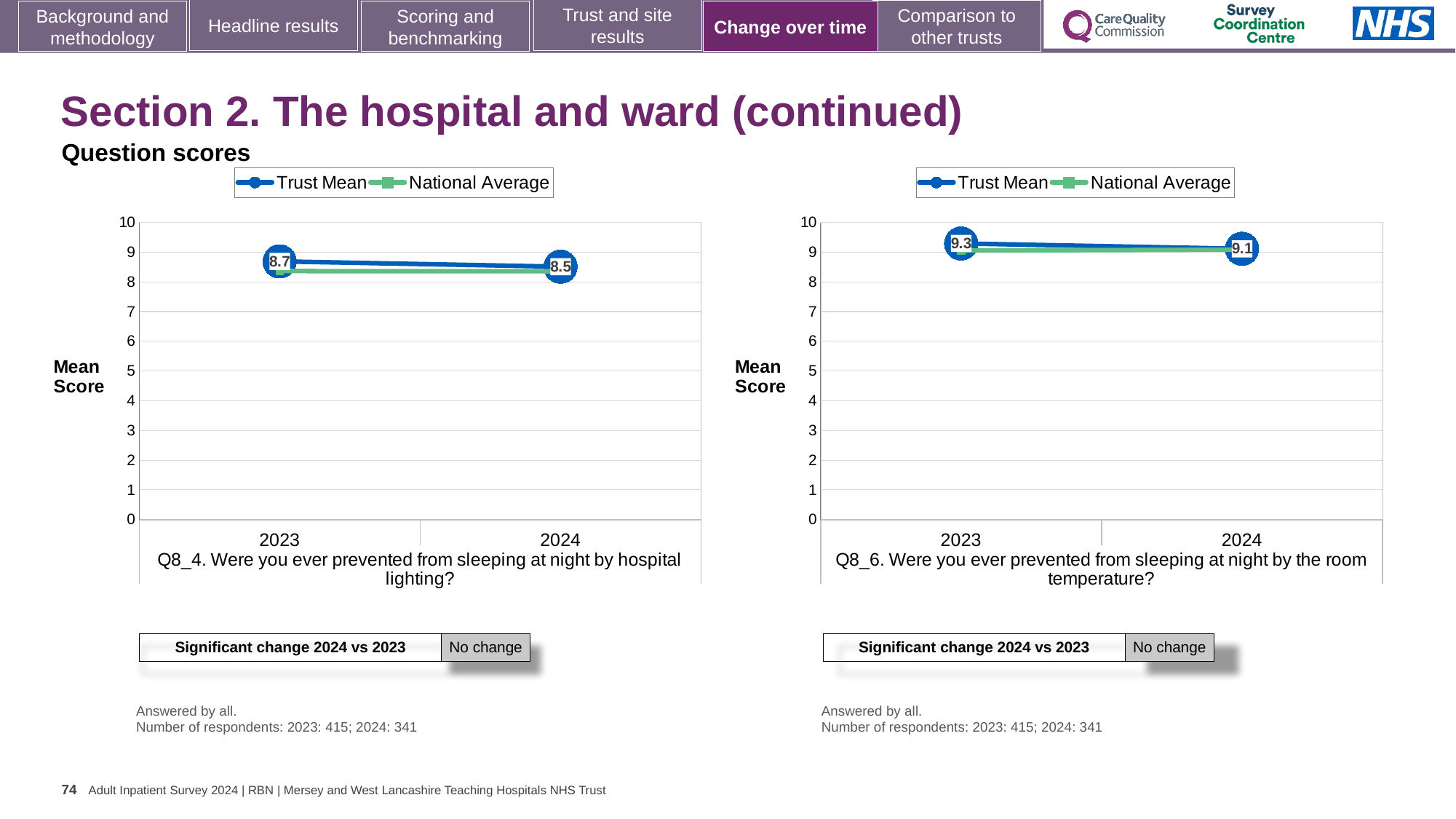
In the Q8_4 hospital lighting chart, is the National Average for 2024 greater or less than 8? greater What does the 'Significant change 2024 vs 2023' box say for the Q8_6 room temperature chart? No change In the Q8_4 hospital lighting chart, by how much did the Trust Mean change from 2023 to 2024? decreased by 0.2 In the Q8_6 room temperature chart, what is the difference between the Trust Mean in 2023 and 2024? 0.2 In the Q8_4 hospital lighting chart, what is the Trust Mean for 2023? 8.7 How many series does the legend of the Q8_6 room temperature chart list? 2 In the Q8_6 room temperature chart, what is the Trust Mean for 2024? 9.1 In the Q8_6 room temperature chart, does the Trust Mean rise or fall from 2023 to 2024? fall Which is larger: the 2023 Trust Mean in the Q8_4 hospital lighting chart or the 2023 Trust Mean in the Q8_6 room temperature chart? Q8_6 room temperature (9.3) What type of chart is the Q8_4 hospital lighting chart? line chart In the Q8_4 hospital lighting chart, what is the Trust Mean for 2024? 8.5 In the Q8_6 room temperature chart, what is the Trust Mean for 2023? 9.3